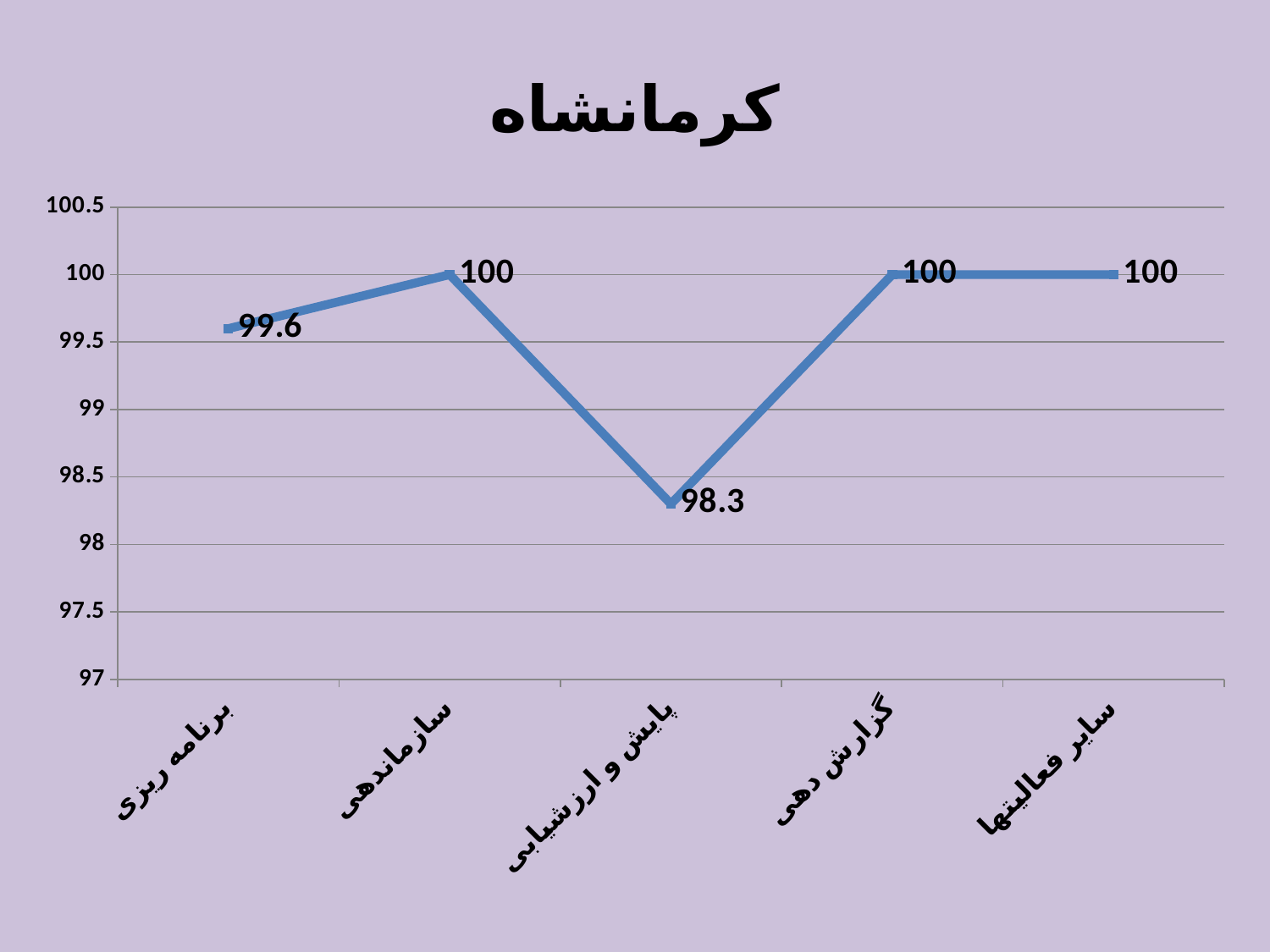
What is the difference between the values for برنامه ریزی and پایش و ارزشیابی? 1.3 What is the difference between the values for سازماندهی and پایش و ارزشیابی? 1.7 What is the title of the chart? کرمانشاه What is the value for سازماندهی? 100 What is the value for پایش و ارزشیابی? 98.3 What kind of chart is shown on the slide? line chart How many categories are shown on the x axis? 5 Which is larger, the value for برنامه ریزی or the value for پایش و ارزشیابی? برنامه ریزی What is the value for گزارش دهی? 100 Is the value for پایش و ارزشیابی greater or less than 99? less Which category has the lowest value? پایش و ارزشیابی What is the value for برنامه ریزی? 99.6